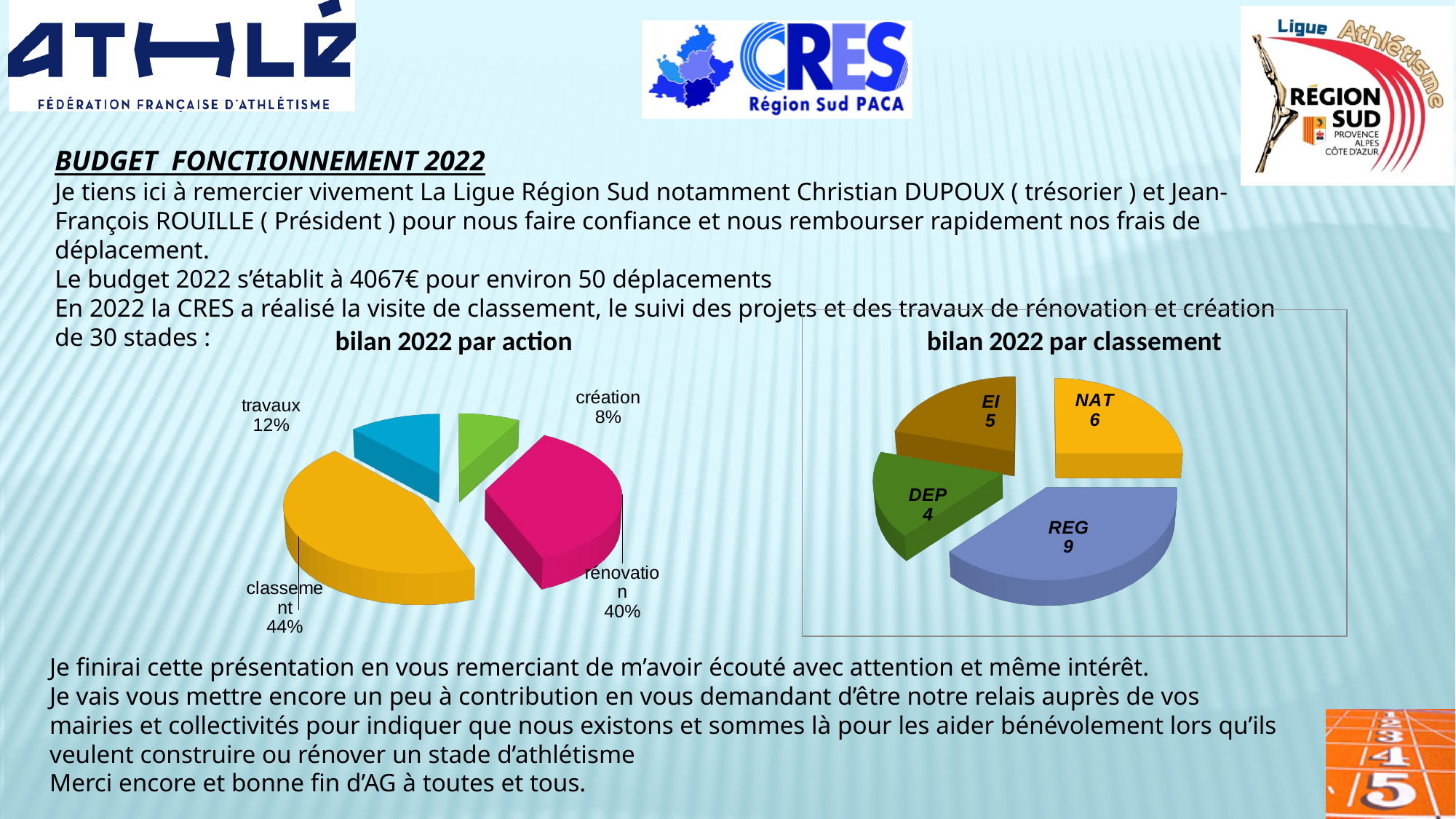
In the 'bilan 2022 par classement' chart, what is the value for DEP? 4 In the 'bilan 2022 par classement' chart, which is larger, EI or NAT? NAT In the 'bilan 2022 par classement' chart, what is the total of all four values? 24 In the 'bilan 2022 par action' chart, what is the difference in percentage points between rénovation and travaux? 28 In the 'bilan 2022 par classement' chart, which category has the highest value? REG In the 'bilan 2022 par action' chart, what percentage is shown for classement? 44% In the 'bilan 2022 par action' chart, which category has the largest share? classement In the 'bilan 2022 par action' chart, what percentage is shown for travaux? 12% In the 'bilan 2022 par action' chart, which category has the smallest share? création In the 'bilan 2022 par action' chart, how many categories are shown? 4 What kind of chart is 'bilan 2022 par classement'? pie chart In the 'bilan 2022 par classement' chart, what is the value for REG? 9